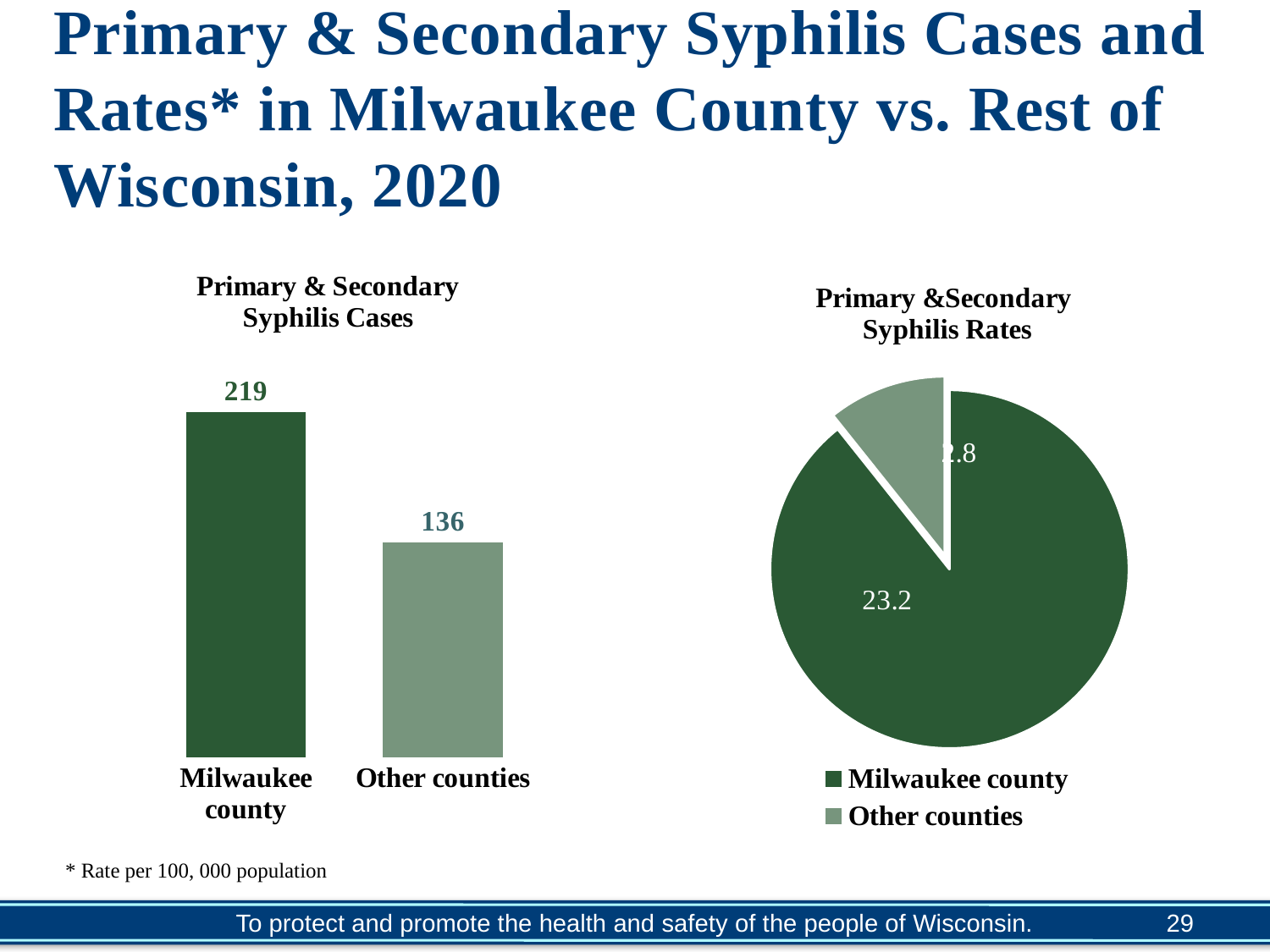
In the Primary & Secondary Syphilis Rates chart, which slice is larger, Milwaukee county or Other counties? Milwaukee county In the Primary & Secondary Syphilis Cases chart, which category has the lower number of cases? Other counties According to the footnote, what are the rates on the slide expressed per? Per 100,000 population In the Primary & Secondary Syphilis Cases chart, how many categories are plotted? 2 In the Primary & Secondary Syphilis Cases chart, what is the difference in cases between Milwaukee county and Other counties? 83 How many entries does the legend of the Primary & Secondary Syphilis Rates chart list? 2 What kind of chart is the Primary & Secondary Syphilis Cases chart? Bar chart In the Primary & Secondary Syphilis Cases chart, which category has the higher number of cases? Milwaukee county In the Primary & Secondary Syphilis Rates chart, what is the rate shown for Milwaukee county? 23.2 In the Primary & Secondary Syphilis Cases chart, how many cases are shown for Other counties? 136 In the Primary & Secondary Syphilis Cases chart, how many cases are shown for Milwaukee county? 219 What kind of chart is the Primary & Secondary Syphilis Rates chart? Pie chart